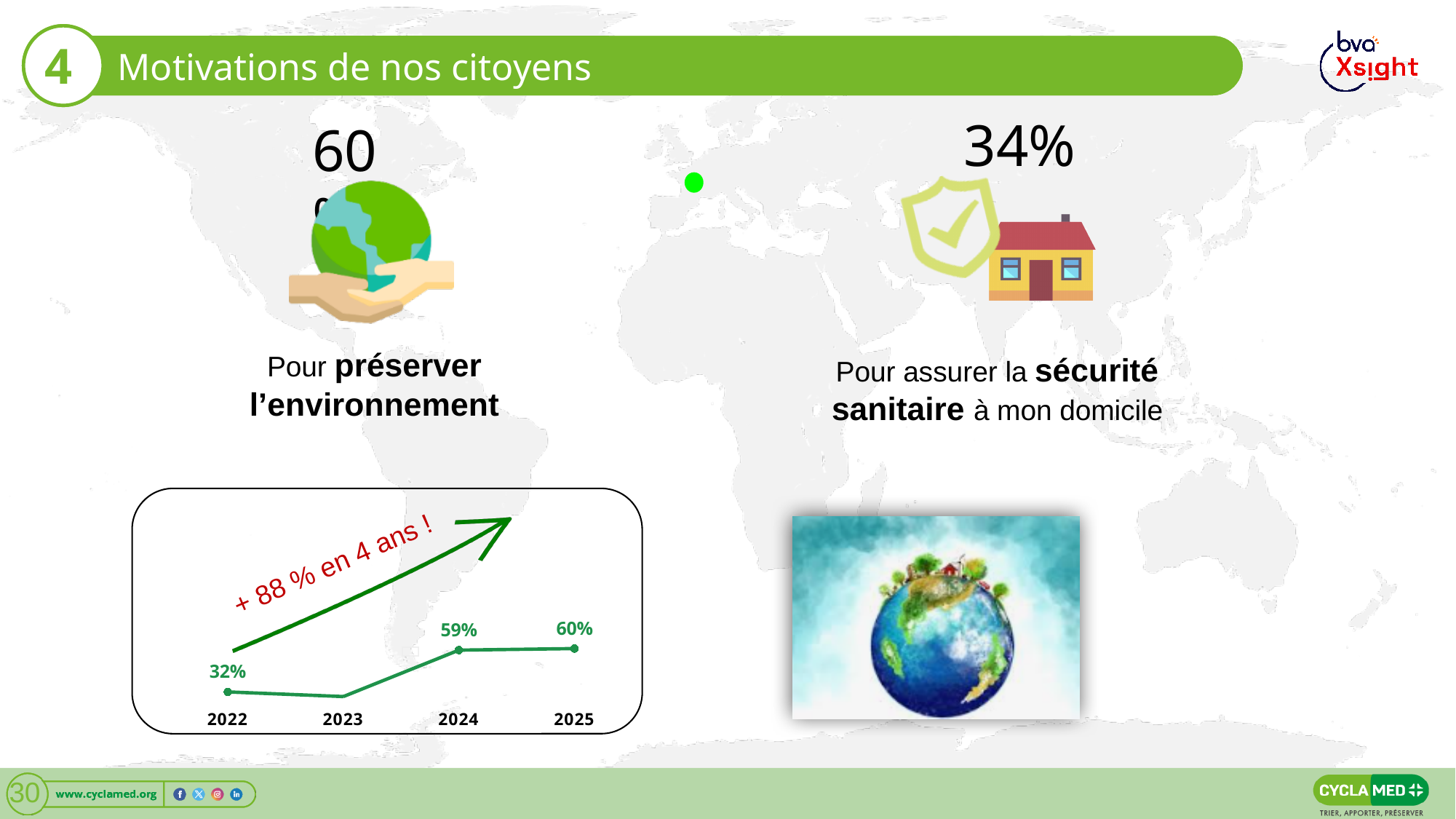
What text is written along the arrow above the line chart? + 88 % en 4 ans ! In the line chart, which year has the highest value? 2025 In the line chart, what is the difference between the 2025 value and the 2022 value? 28% In the line chart, what is the value for 2022? 32% In the line chart, which year has the lowest value? 2023 What kind of chart is shown in the bottom-left box of the slide? line chart In the line chart, is the value for 2024 or the value for 2022 larger? 2024 Do the values in the line chart rise or fall from 2022 to 2025? rise How many years are shown on the x axis of the line chart? 4 In the line chart, what is the value for 2024? 59% In the line chart, what is the difference between the 2024 value and the 2022 value? 27% In the line chart, what is the value for 2025? 60%